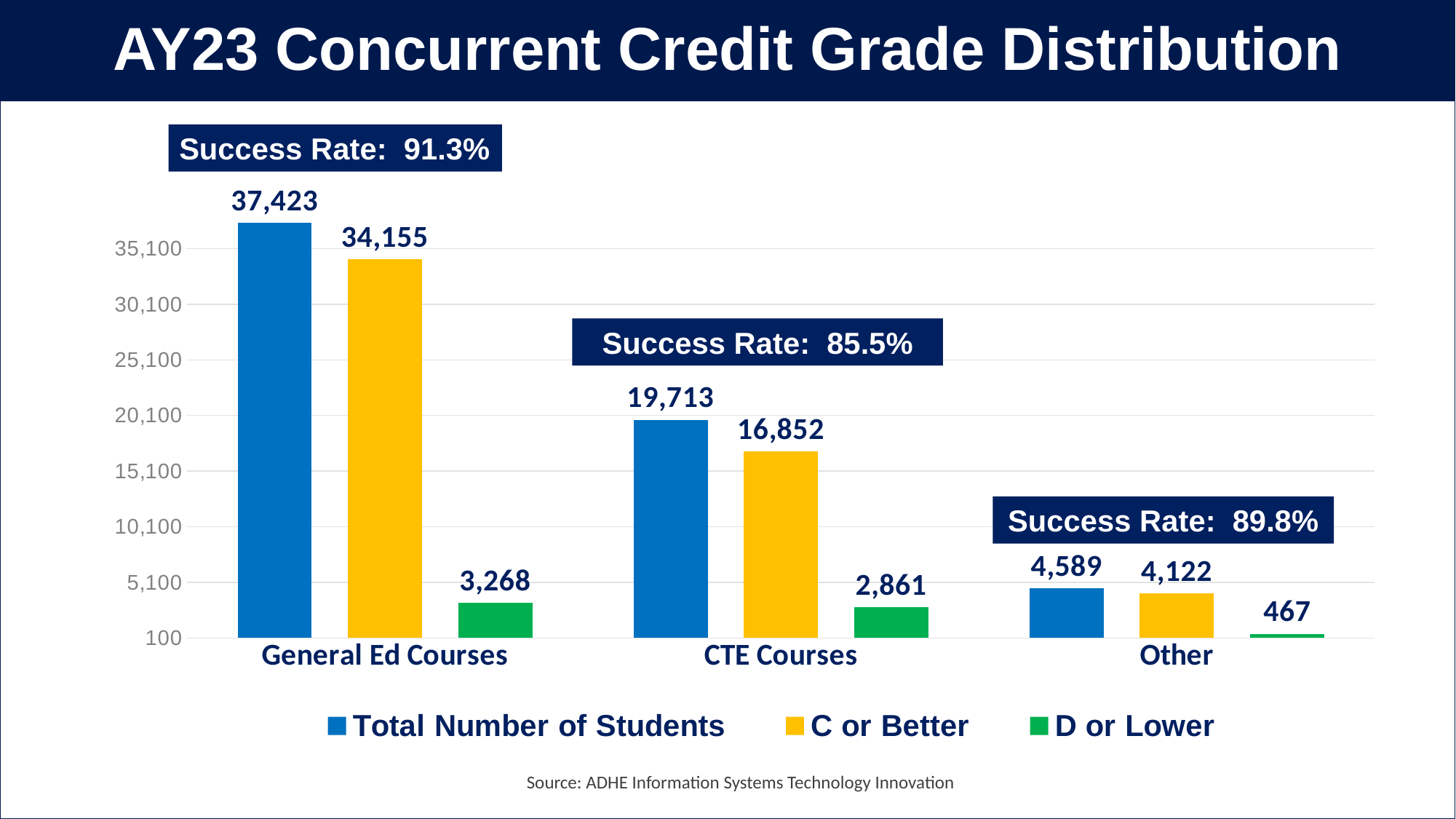
How many categories are shown on the x axis? 3 Which is larger: the D or Lower value for General Ed Courses or for CTE Courses? General Ed Courses How many series does the legend list? 3 What is the Total Number of Students for General Ed Courses? 37,423 What is the C or Better value for CTE Courses? 16,852 What is the success rate shown for CTE Courses? 85.5% What is the D or Lower value for Other? 467 What is the title of the chart? AY23 Concurrent Credit Grade Distribution What is the difference between the Total Number of Students and the C or Better value for General Ed Courses? 3,268 Which category has the highest Total Number of Students? General Ed Courses Which category has the lowest D or Lower value? Other What kind of chart is shown on the slide? Bar chart